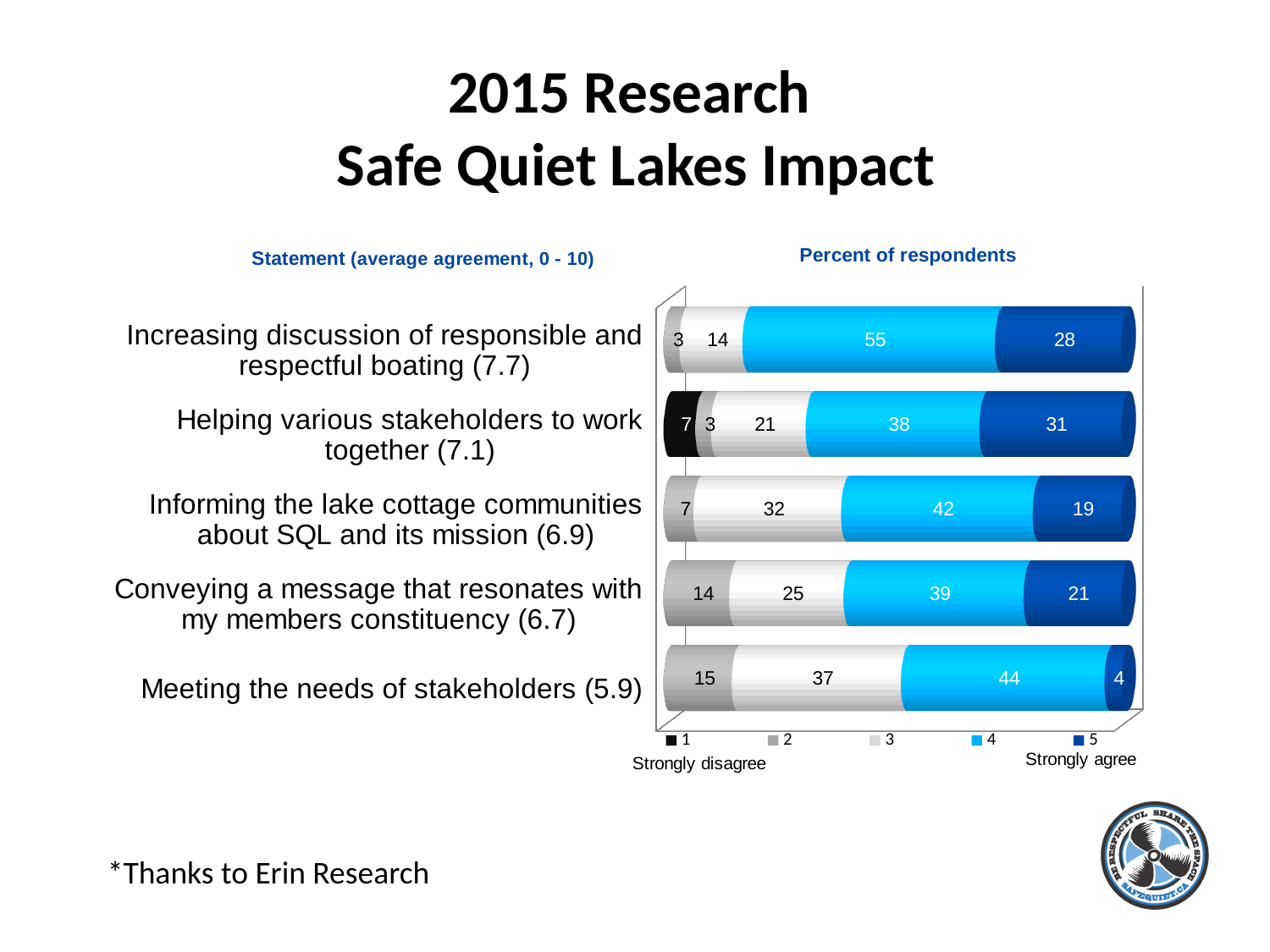
How many statements (categories) are plotted in the chart? 5 What is the difference between the percent rating 4 for 'Increasing discussion of responsible and respectful boating' and the percent rating 4 for 'Helping various stakeholders to work together'? 17 Which statement has the highest percent of respondents rating it 5 (Strongly agree)? Helping various stakeholders to work together (7.1) Which statement has the lowest percent of respondents rating it 5 (Strongly agree)? Meeting the needs of stakeholders (5.9) What type of chart is shown on the slide? stacked bar chart What percent of respondents gave a rating of 4 for 'Increasing discussion of responsible and respectful boating'? 55 What percent of respondents gave a rating of 5 for 'Helping various stakeholders to work together'? 31 How many series does the chart legend list? 5 What percent of respondents gave a rating of 1 for 'Helping various stakeholders to work together'? 7 What percent of respondents gave a rating of 3 for 'Meeting the needs of stakeholders'? 37 What is the average agreement score shown for 'Conveying a message that resonates with my members constituency'? 6.7 Which is larger: the percent rating 2 for 'Meeting the needs of stakeholders' or the percent rating 2 for 'Informing the lake cottage communities about SQL and its mission'? Meeting the needs of stakeholders